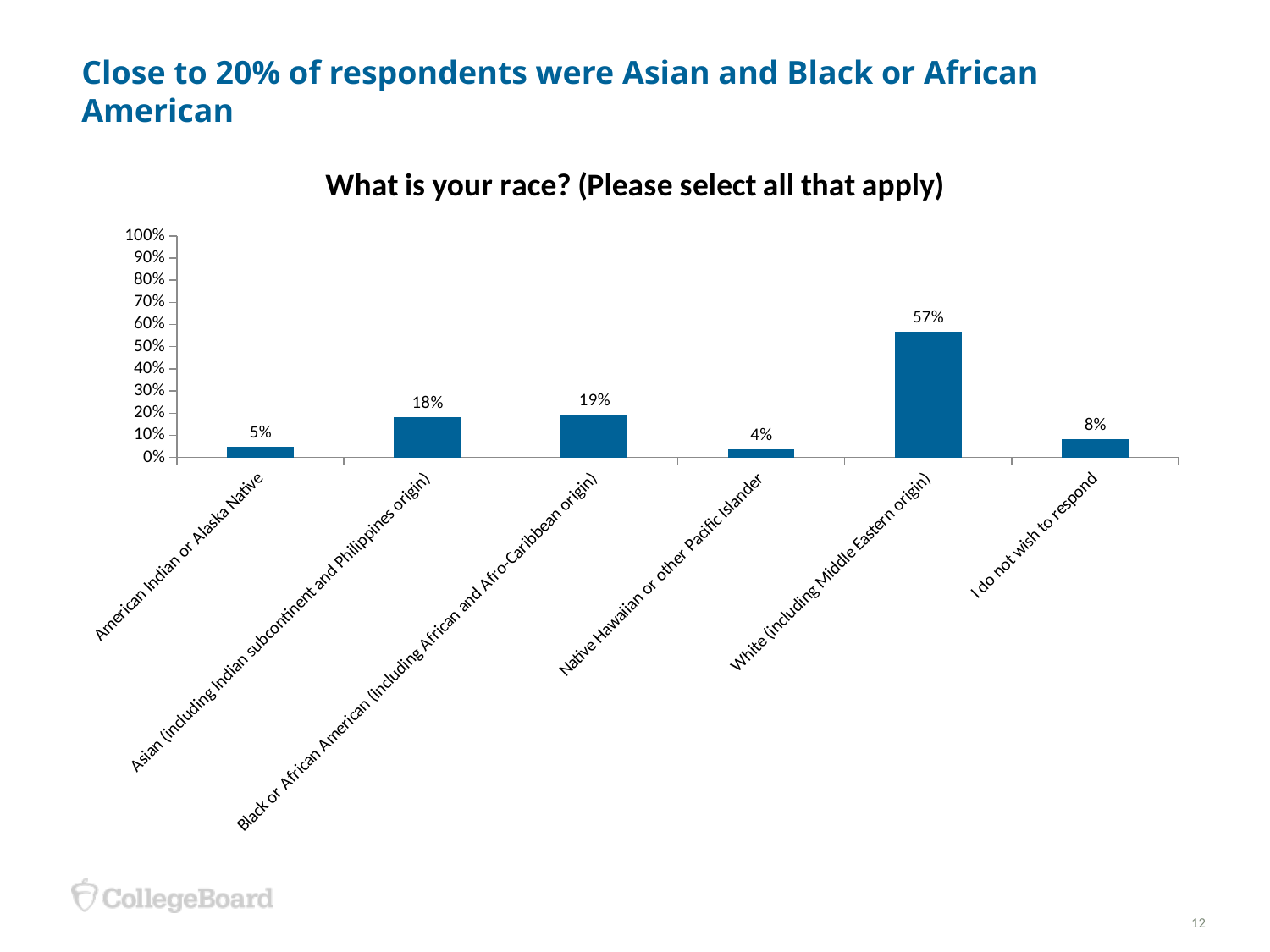
What percentage of respondents selected White (including Middle Eastern origin)? 57% How many race categories are shown on the chart? 6 What is the difference in percentage points between White (including Middle Eastern origin) and Black or African American (including African and Afro-Caribbean origin)? 38 What is the title of the chart? What is your race? (Please select all that apply) Which race category has the highest percentage of respondents? White (including Middle Eastern origin) Which has a higher percentage: American Indian or Alaska Native, or 'I do not wish to respond'? I do not wish to respond What percentage of respondents selected Native Hawaiian or other Pacific Islander? 4% Which race category has the lowest percentage of respondents? Native Hawaiian or other Pacific Islander What percentage of respondents selected Asian (including Indian subcontinent and Philippines origin)? 18% What type of chart is used to display the race data? Bar chart Is the value for White (including Middle Eastern origin) greater or less than 50%? greater What percentage of respondents chose 'I do not wish to respond'? 8%